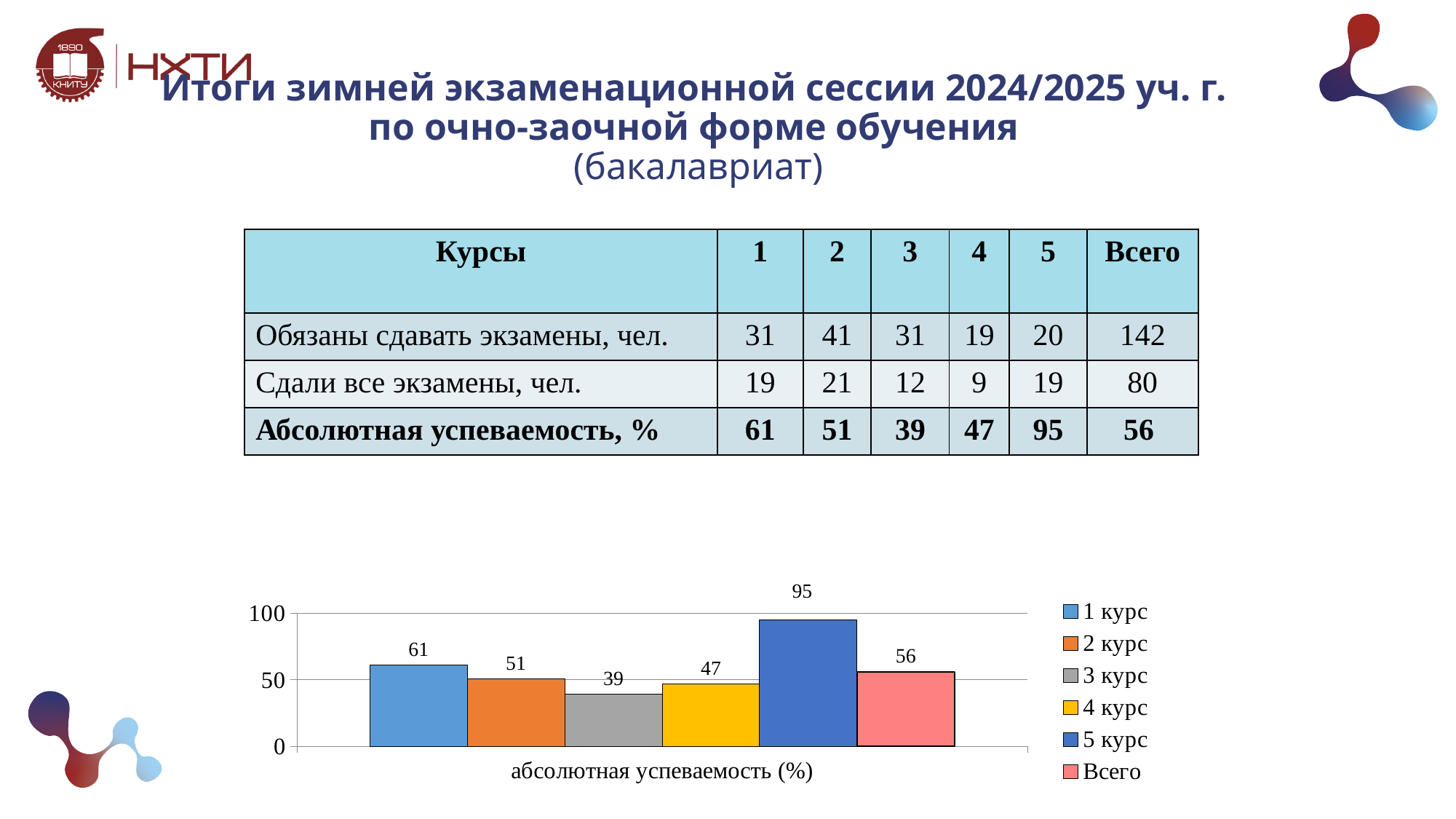
What is the value for 1 курс in the chart? 61 Is the value for 5 курс greater or less than 50? greater What kind of chart is shown on the slide? bar chart What colour is the bar for 4 курс? yellow What is the value for Всего in the chart? 56 Which series has the lowest value in the chart? 3 курс How many series does the legend list? 6 Which series has the highest value in the chart? 5 курс Which is larger, the value for 2 курс or the value for 4 курс? 2 курс What is the value for 3 курс in the chart? 39 What is the x-axis label of the chart? абсолютная успеваемость (%) What is the difference between the values for 5 курс and 1 курс? 34